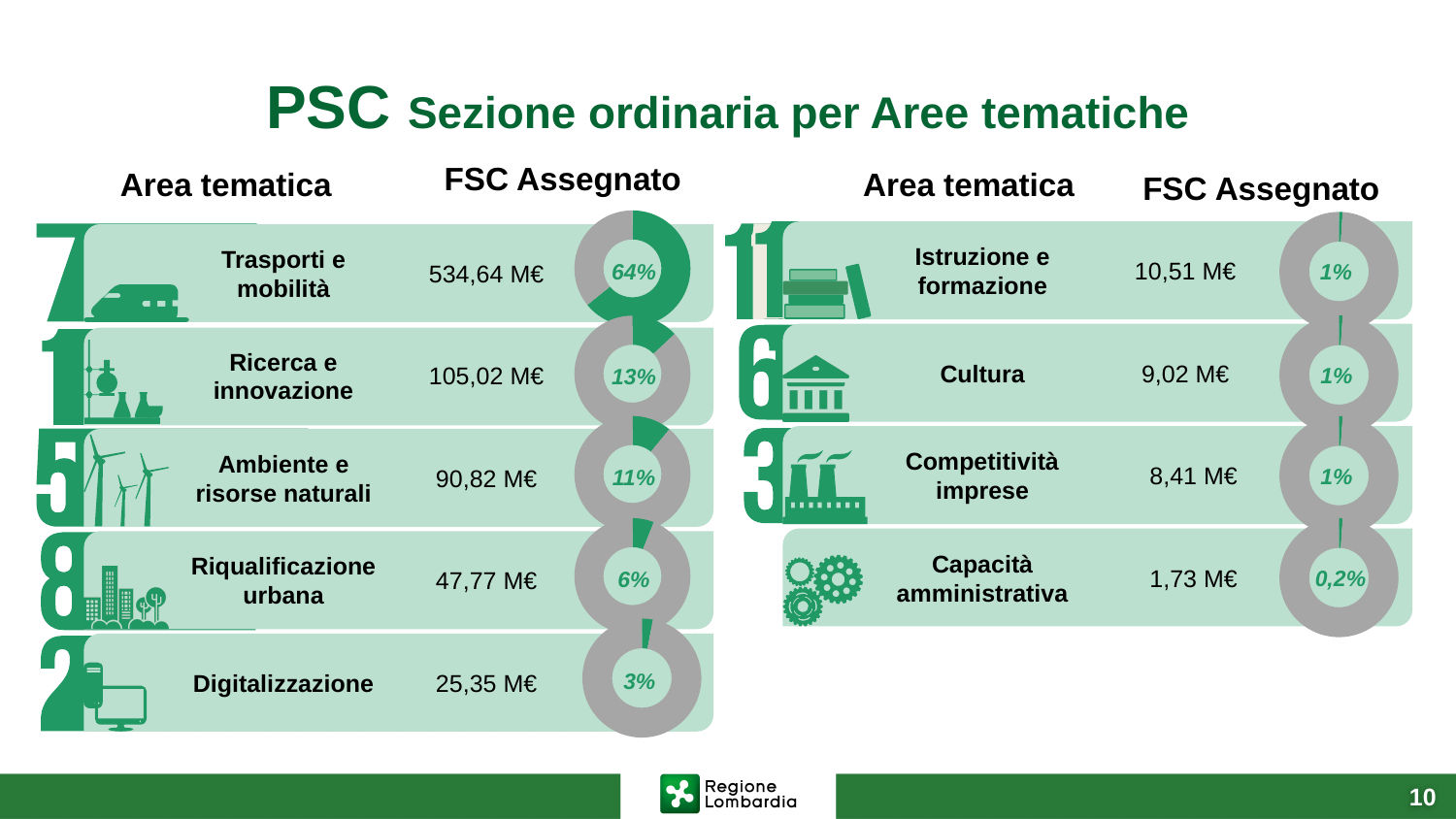
Which thematic area has the lowest FSC Assegnato? Capacità amministrativa What kind of chart is used to show the percentage share for each thematic area? Donut (pie) chart What FSC amount is assigned to Ambiente e risorse naturali? 90,82 M€ How many thematic areas are shown on the slide? 9 What FSC amount is assigned to Trasporti e mobilità? 534,64 M€ What FSC amount is assigned to Competitività imprese? 8,41 M€ What is the difference in FSC Assegnato between Istruzione e formazione and Cultura? 1,49 M€ What percentage share is shown in the donut chart for Ricerca e innovazione? 13% What percentage share is shown for Capacità amministrativa? 0,2% What is the difference in FSC Assegnato between Trasporti e mobilità and Ricerca e innovazione? 429,62 M€ Which thematic area has the highest FSC Assegnato? Trasporti e mobilità Which has a larger FSC Assegnato, Riqualificazione urbana or Digitalizzazione? Riqualificazione urbana